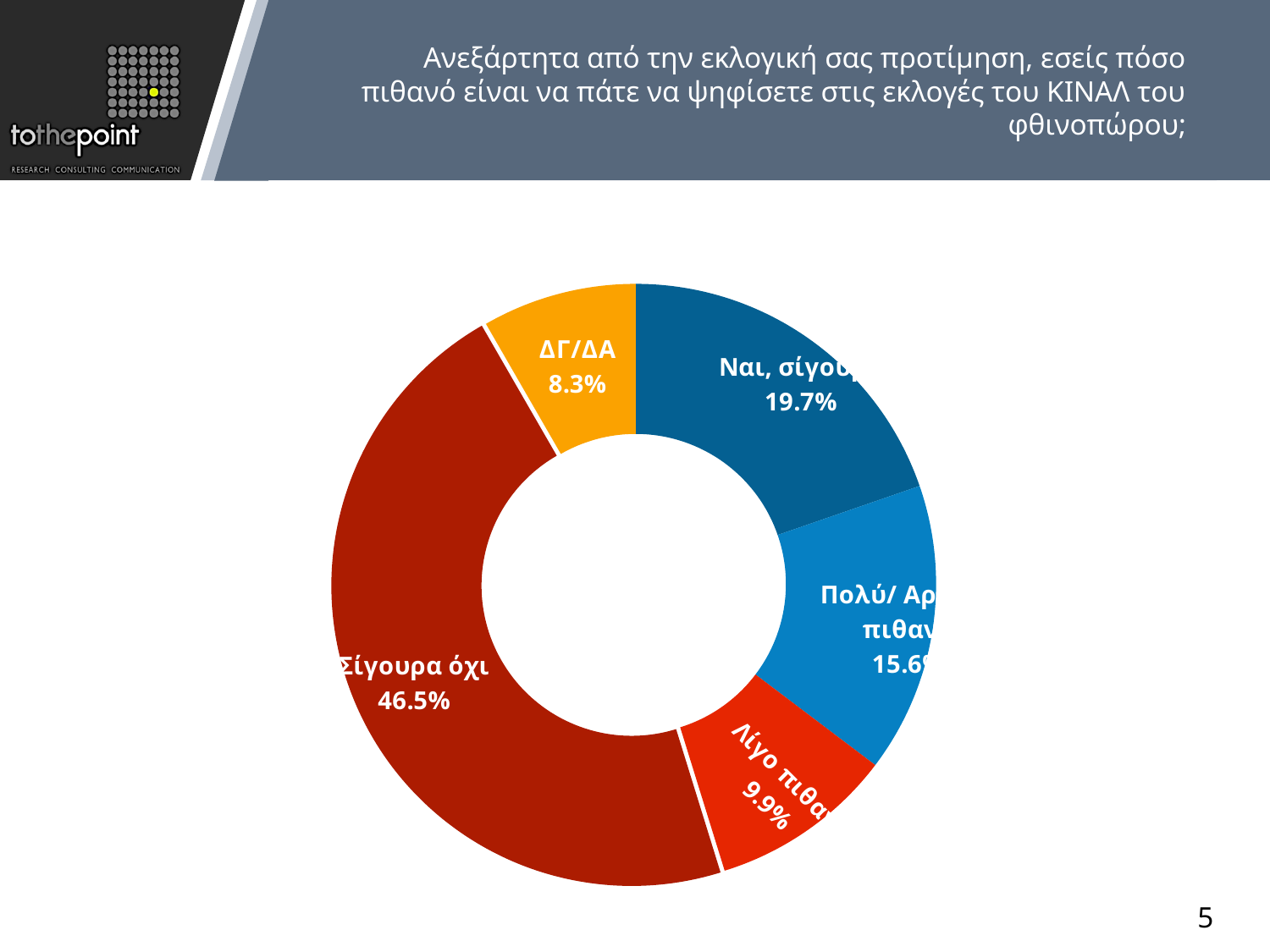
Which slice of the doughnut chart is the largest? Σίγουρα όχι What percentage is shown for the "Σίγουρα όχι" slice? 46.5% What percentage is shown for the "ΔΓ/ΔΑ" slice? 8.3% How many slices does the doughnut chart have? 5 What colour is the "Σίγουρα όχι" slice? Dark red What is the difference in percentage points between the "Σίγουρα όχι" slice and the "ΔΓ/ΔΑ" slice? 38.2% What percentage is shown on the dark blue slice at the top right, labelled "Ναι, σίγου…"? 19.7% What percentage is shown on the bright red slice at the bottom right, labelled "Λίγο πιθα…"? 9.9% What kind of chart is shown on the slide? Doughnut (pie) chart What share of the whole does the "ΔΓ/ΔΑ" slice represent? 8.3% Which is larger, the "ΔΓ/ΔΑ" slice or the "Λίγο πιθα…" slice? Λίγο πιθα… Which slice of the doughnut chart is the smallest? ΔΓ/ΔΑ